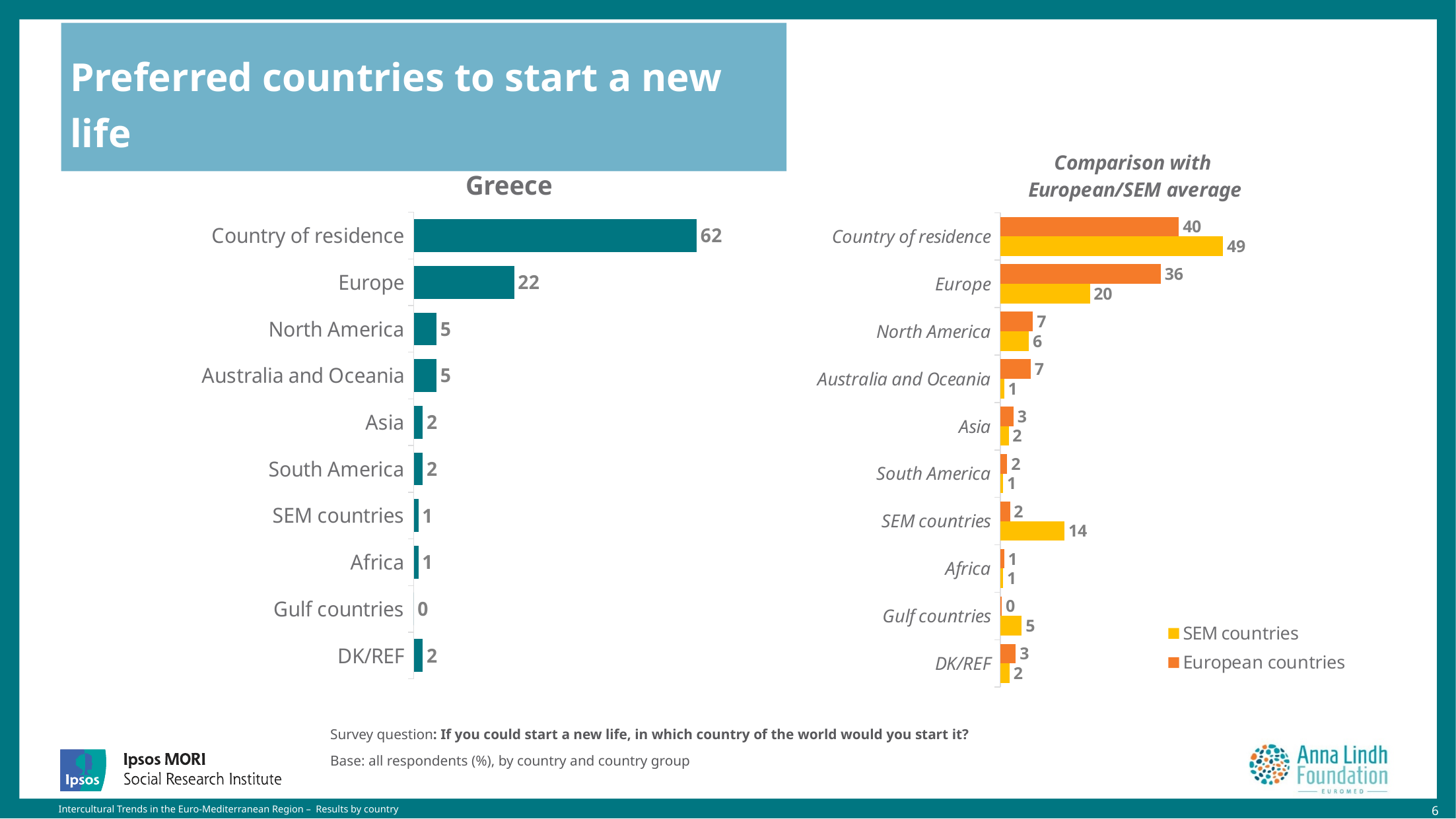
In the Comparison with European/SEM average chart, how many series does the legend list? 2 In the Comparison with European/SEM average chart, what is the value for European countries for Europe? 36 In the Greece chart, which category has the highest value? Country of residence In the Greece chart, how many categories are shown? 10 In the Greece chart, what is the value for Country of residence? 62 What kind of chart is the Greece chart? Bar chart In the Comparison with European/SEM average chart, which is larger for SEM countries as a destination: the SEM countries value or the European countries value? SEM countries In the Greece chart, what is the difference between Country of residence and Europe? 40 In the Greece chart, what is the value for Europe? 22 In the Comparison with European/SEM average chart, what is the value for SEM countries for the Country of residence category? 49 In the Comparison with European/SEM average chart, what is the difference between the SEM countries and European countries values for Gulf countries? 5 In the Greece chart, which category has the lowest value? Gulf countries